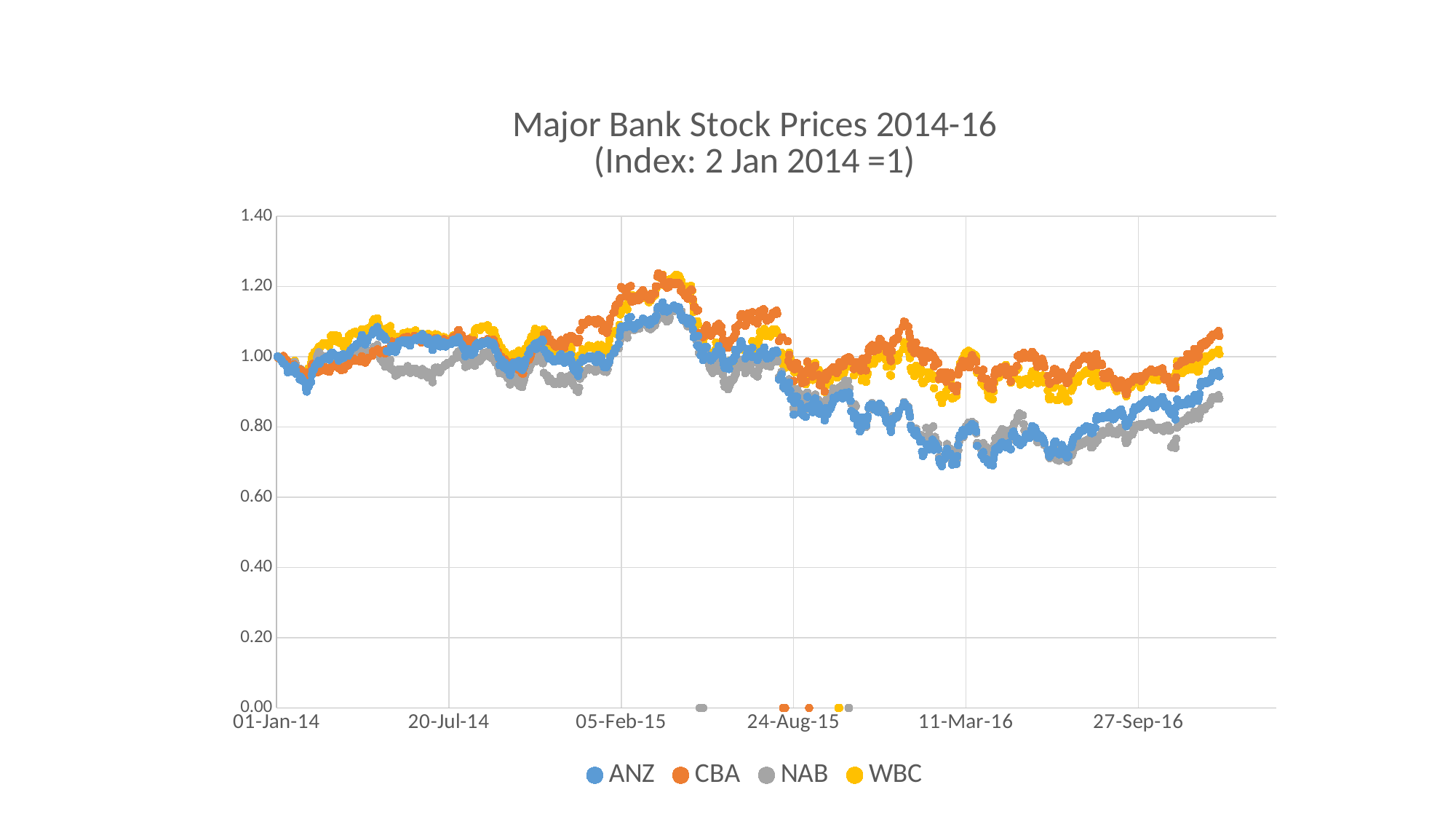
Is the lowest value reached by ANZ greater or less than 0.80? less Around 11-Mar-16, which series has the higher value, CBA or ANZ? CBA Do the values for CBA rise or fall between 27-Sep-16 and the end of the series? rise How many series does the legend list? 4 Is the value for NAB at the end of the series (late 2016) greater or less than 0.80? greater What kind of chart is shown on the slide? scatter chart What are the series names listed in the legend? ANZ, CBA, NAB, WBC What is the title of the chart? Major Bank Stock Prices 2014-16 (Index: 2 Jan 2014 =1) Is the highest value reached by CBA greater or less than 1.20? greater Do the values for ANZ rise or fall between 05-Feb-15 and 11-Mar-16? fall Around 11-Mar-16, which series has the higher value, WBC or NAB? WBC